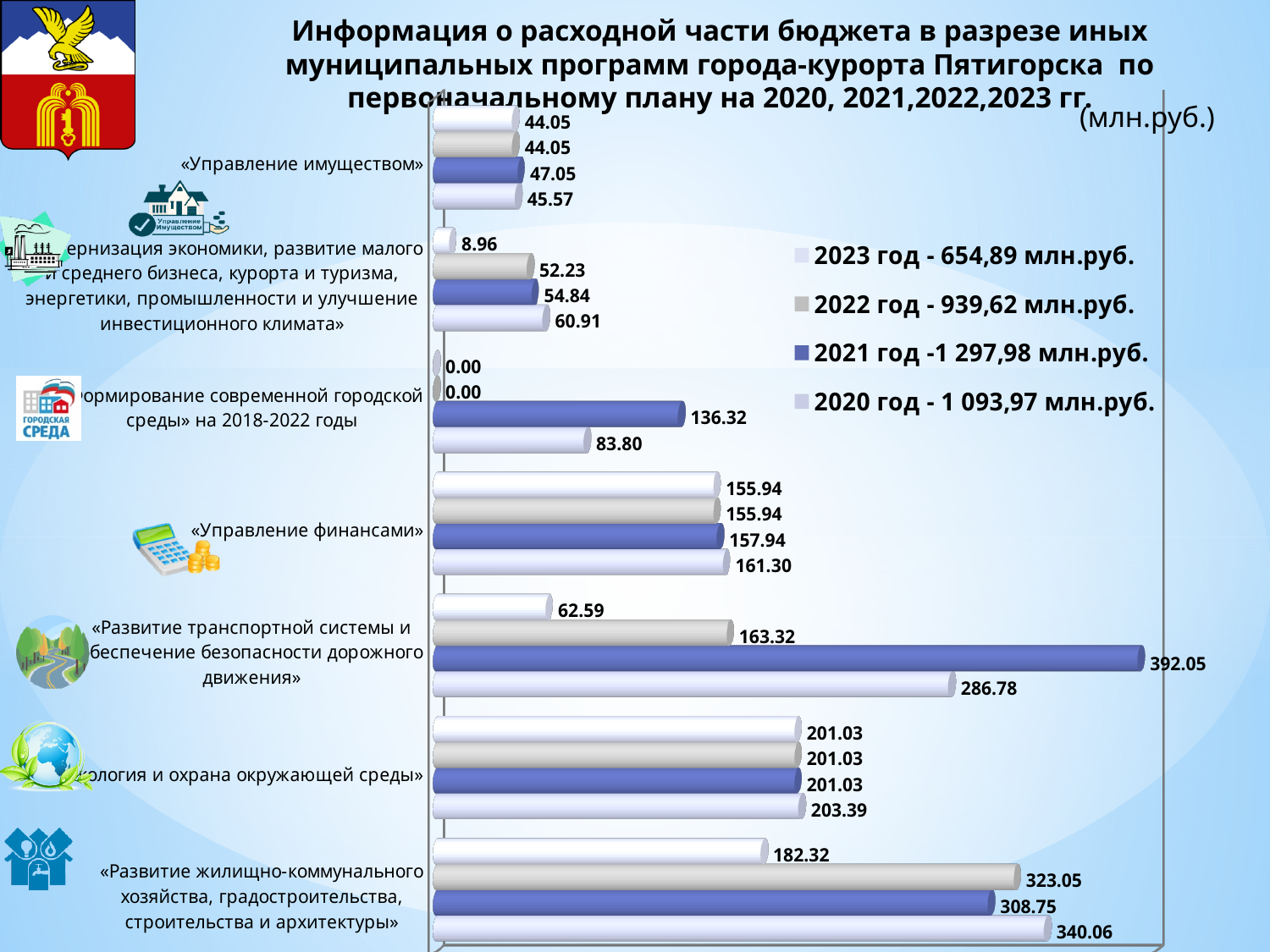
What is the 2021 value for «Управление имуществом»? 47.05 What is the 2023 value for «Развитие жилищно-коммунального хозяйства, градостроительства, строительства и архитектуры»? 182.32 What total for 2021 год is given in the legend? 1 297,98 млн.руб. What is the 2021 value for «Развитие транспортной системы и обеспечение безопасности дорожного движения»? 392.05 How many program categories are plotted on the chart? 7 What is the 2020 value for «Управление финансами»? 161.30 How many series does the legend list? 4 Which category has the highest single bar on the chart? «Развитие транспортной системы и обеспечение безопасности дорожного движения» What is the difference between the 2021 and 2020 values for «Развитие транспортной системы и обеспечение безопасности дорожного движения»? 105.27 Which is larger for «Развитие жилищно-коммунального хозяйства, градостроительства, строительства и архитектуры»: the 2022 value or the 2021 value? 2022 value (323.05) What is the difference between the 2020 and 2023 values for «Управление финансами»? 5.36 What type of chart is shown on the slide? bar chart